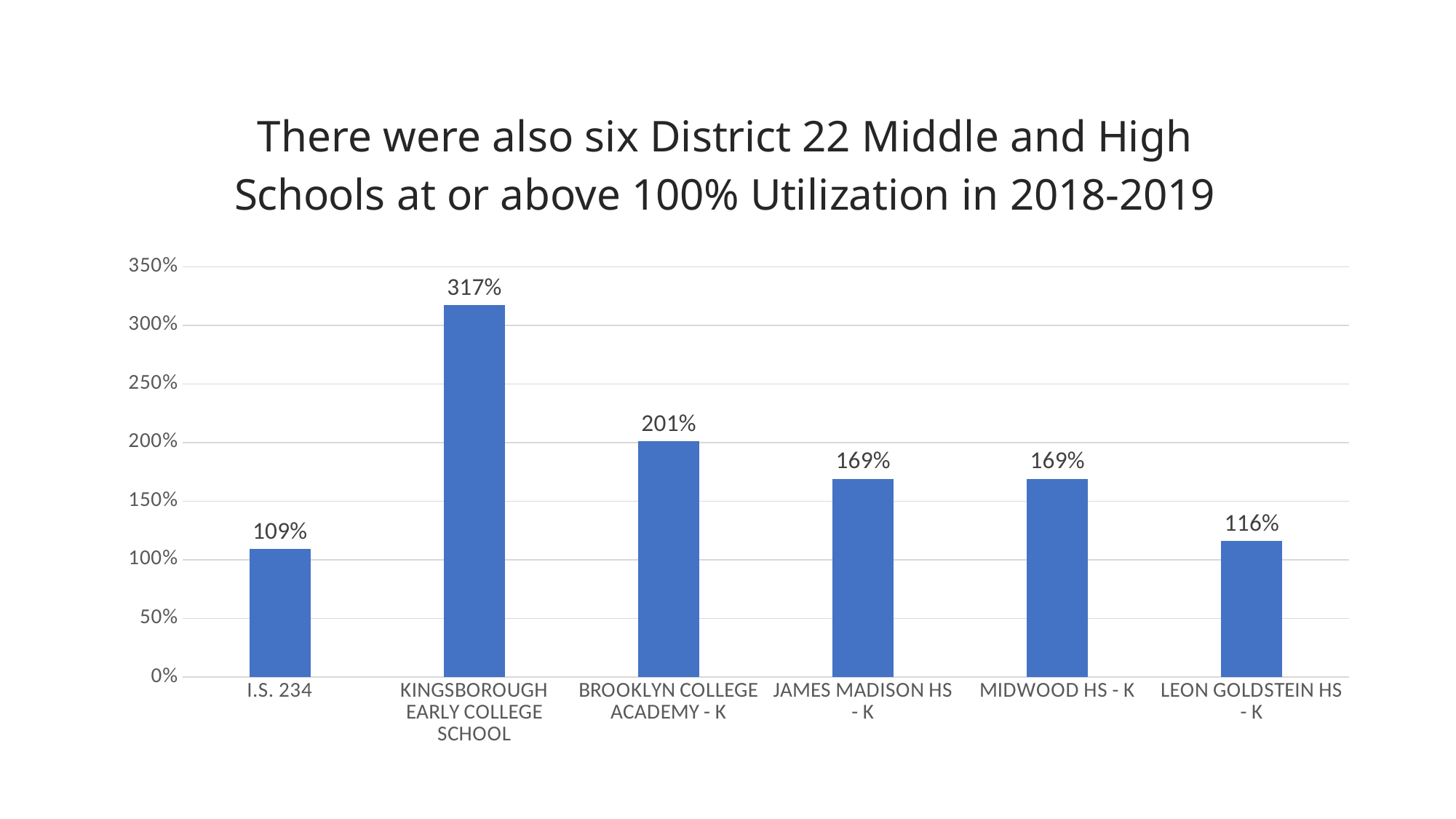
What is the difference between the utilization of Leon Goldstein HS - K and I.S. 234? 7% What is the utilization value for Leon Goldstein HS - K? 116% Which has a higher utilization, Brooklyn College Academy - K or James Madison HS - K? Brooklyn College Academy - K Which school has the lowest utilization? I.S. 234 What is the utilization value for Brooklyn College Academy - K? 201% What is the utilization value for Kingsborough Early College School? 317% How many schools are shown in the chart? 6 What is the difference between the utilization of Kingsborough Early College School and Brooklyn College Academy - K? 116% What is the title of the chart? There were also six District 22 Middle and High Schools at or above 100% Utilization in 2018-2019 Which school has the highest utilization? Kingsborough Early College School What is the utilization value for I.S. 234? 109% What kind of chart is shown on the slide? Bar chart